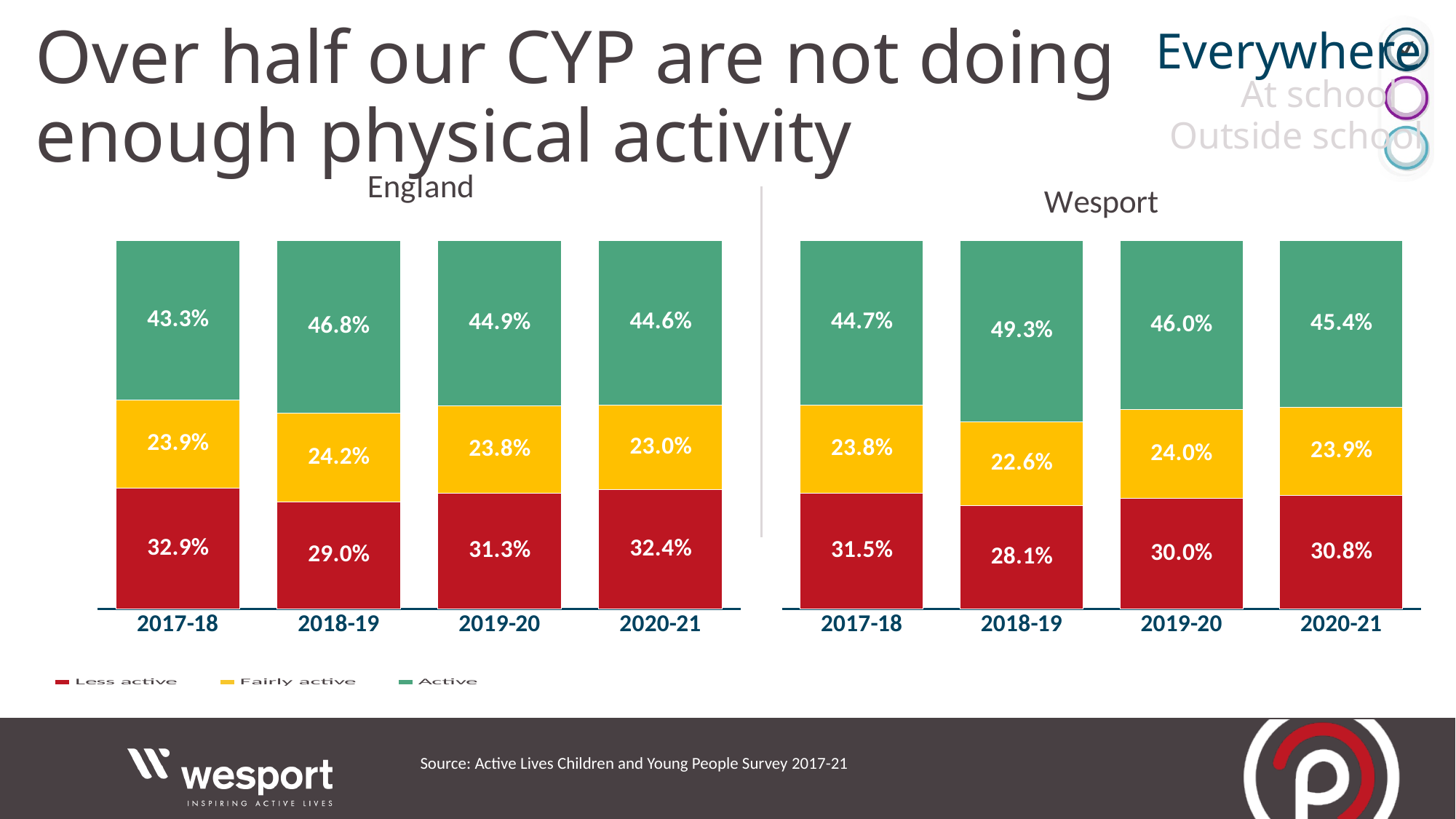
What type of chart is used for the England and Wesport data? Stacked bar chart In the England chart, what percentage of CYP were Active in 2018-19? 46.8% In the Wesport chart, which year has the highest Active percentage? 2018-19 In the Wesport chart, what is the Fairly active value for 2019-20? 24.0% In the England chart, by how much did the Less active percentage fall from 2017-18 to 2018-19? 3.9 percentage points Which is larger: the Active percentage for England in 2020-21 or for Wesport in 2020-21? Wesport in 2020-21 How many years are shown on the x axis of the England chart? 4 What is the difference between the Wesport and England Active percentages in 2018-19? 2.5 percentage points How many series does the legend list? 3 In the England chart, which year has the lowest Less active percentage? 2018-19 In the Wesport chart, what percentage of CYP were Less active in 2020-21? 30.8% Which colour represents the Less active series in the legend? Red